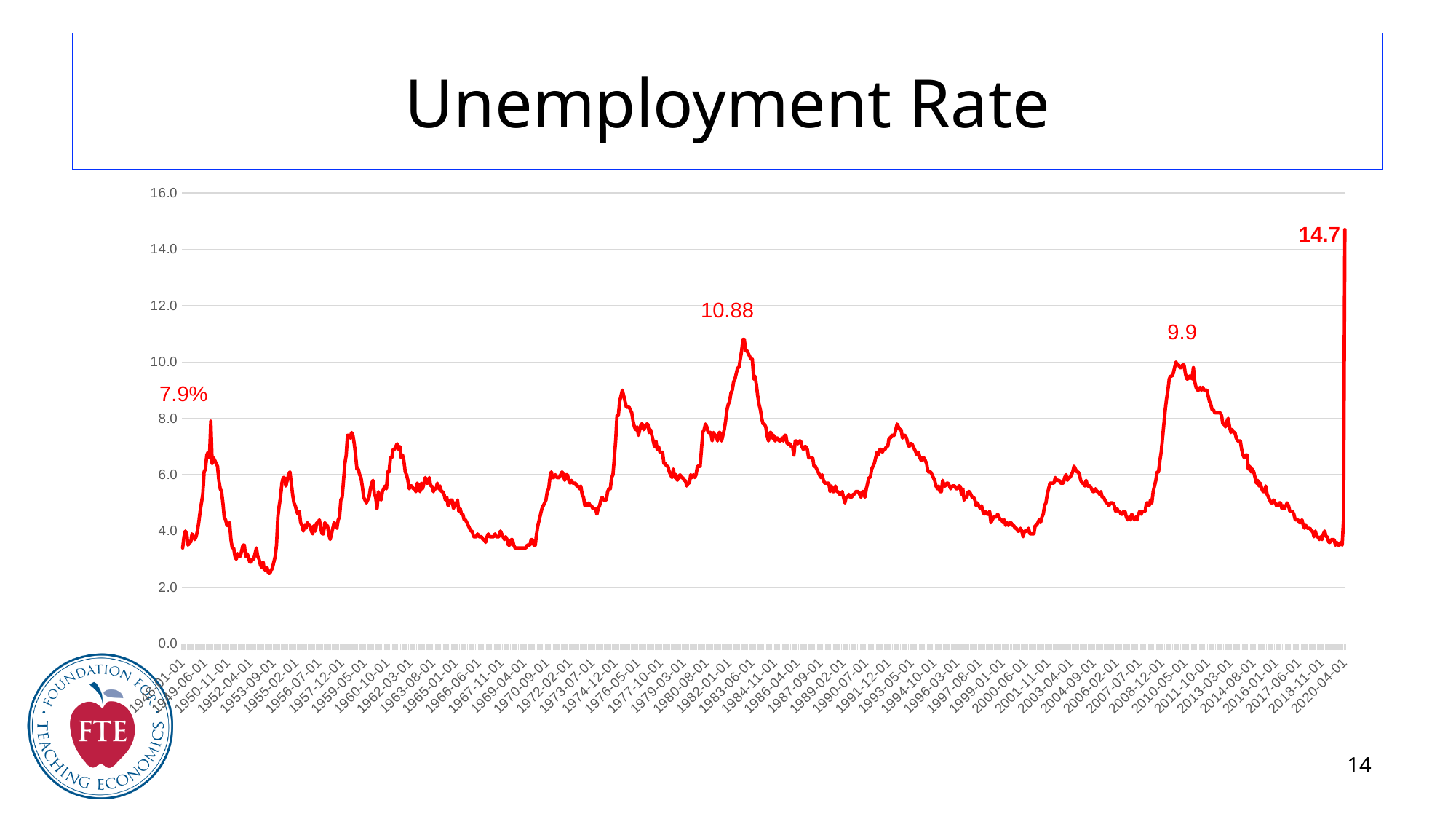
Which is larger, the labeled peak of 10.88 or the labeled peak of 9.9? 10.88 What type of chart is shown on the slide? line chart What is the labeled value at the peak around 1949? 7.9% Which labeled peak has the highest value? 14.7 Is the value around 1953-09-01 greater or less than 4.0? less What is the labeled value at the peak around 2009-2010? 9.9 Do the values rise or fall between 2010 and 2019? fall What is the title of the chart? Unemployment Rate What is the labeled value at the final spike in 2020? 14.7 What is the difference between the 14.7 peak and the 10.88 peak? 3.82 What is the labeled value at the peak in the early 1980s? 10.88 What colour is the plotted line? red